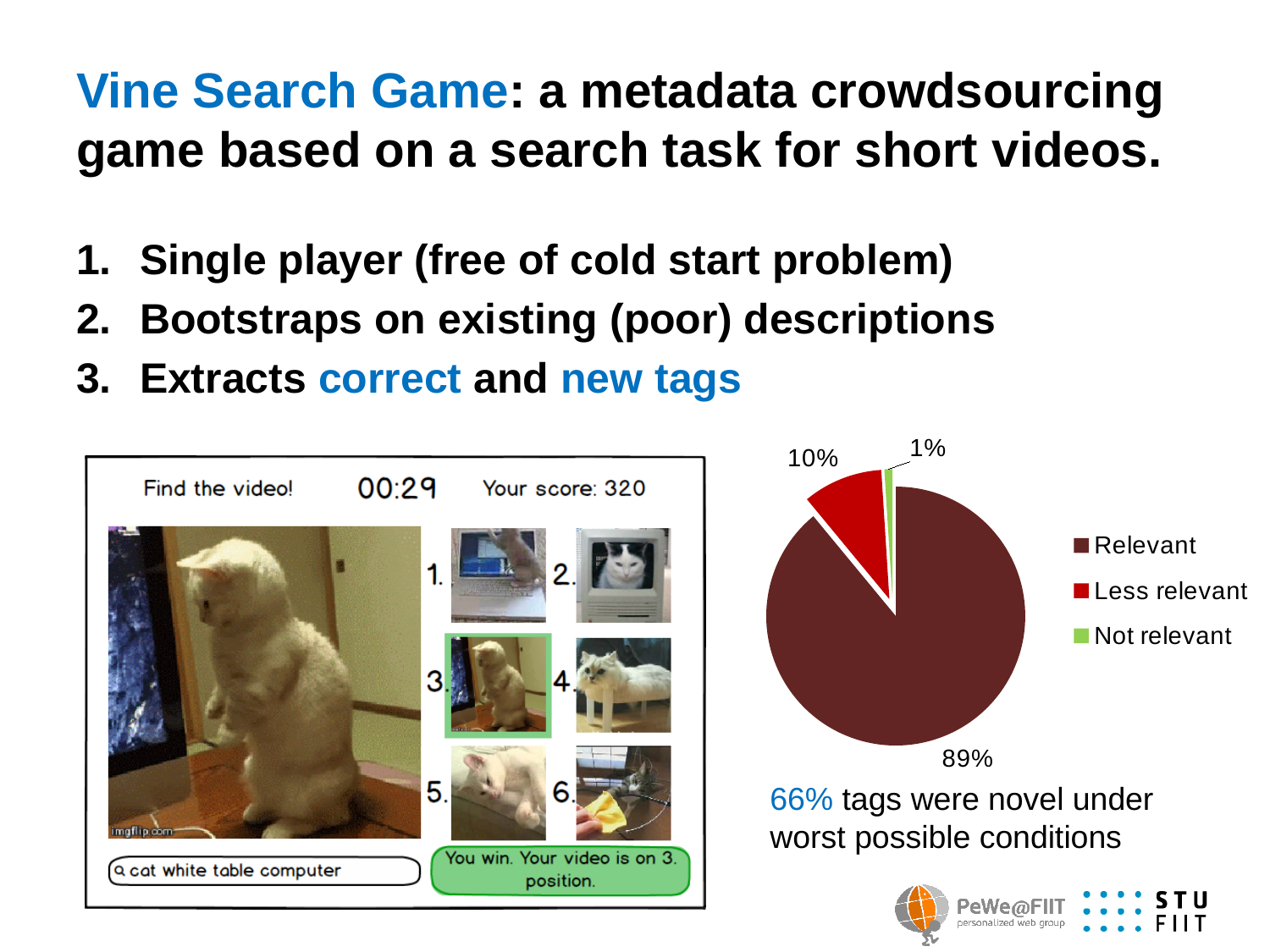
Which category has the largest slice of the pie? Relevant What kind of chart is shown on the slide? pie chart How many entries does the legend of the pie chart list? 3 What share of the pie is labelled Not relevant? 1% How many slices does the pie chart have? 3 What share of the pie is labelled Less relevant? 10% What is the difference in percentage points between the Relevant and Less relevant slices? 79 Which slice is larger, Less relevant or Not relevant? Less relevant What share of the pie is labelled Relevant? 89% What colour is the Relevant slice in the pie chart? dark red What is the difference in percentage points between the Less relevant and Not relevant slices? 9 Which category has the smallest slice of the pie? Not relevant